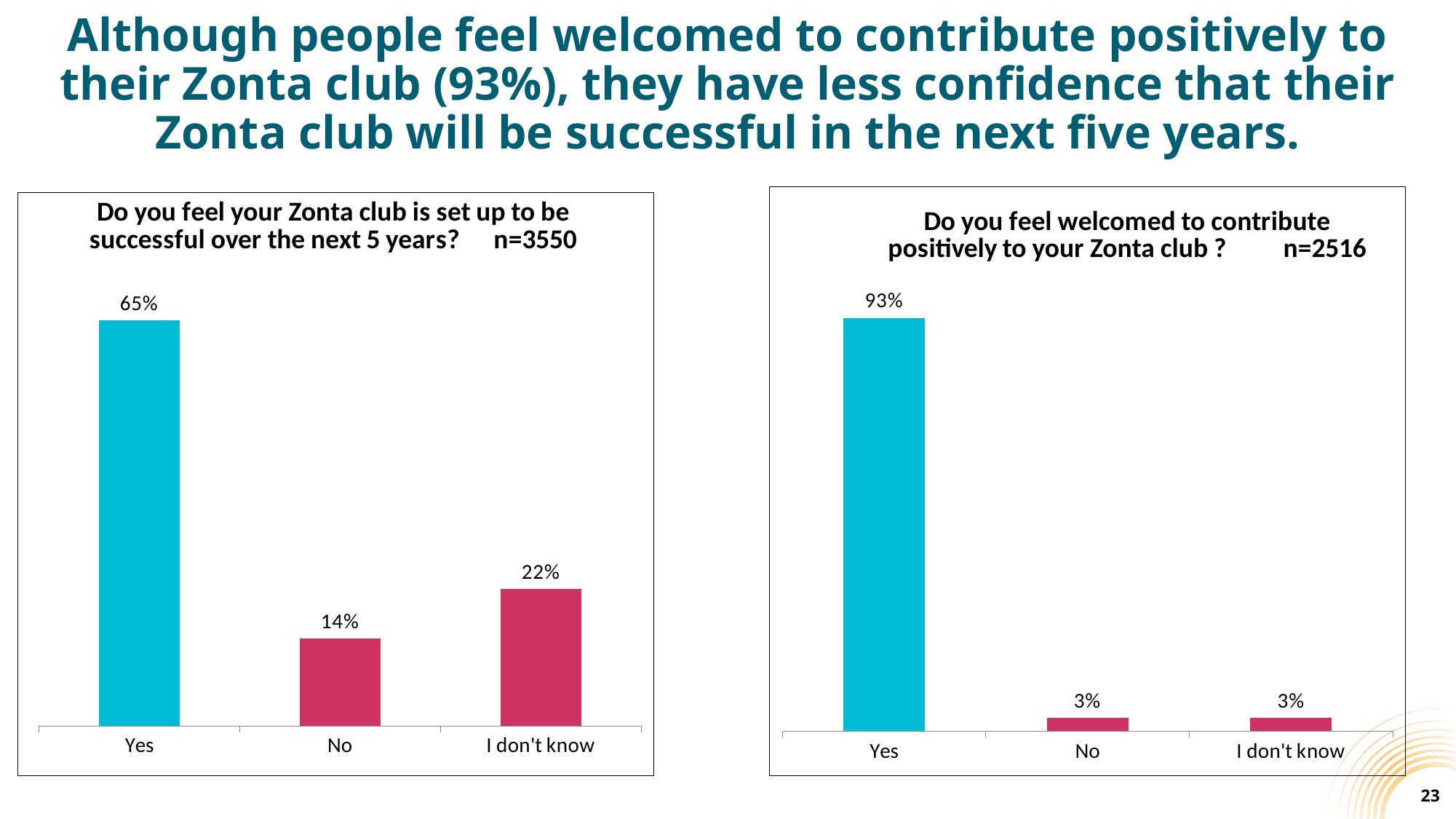
In the left chart (Do you feel your Zonta club is set up to be successful over the next 5 years?), which category has the lowest value? No In the right chart (Do you feel welcomed to contribute positively to your Zonta club?), what is the value for No? 3% In the left chart (Do you feel your Zonta club is set up to be successful over the next 5 years?), what is the value for I don't know? 22% How many categories are shown in the right chart (Do you feel welcomed to contribute positively to your Zonta club?)? 3 In the right chart (Do you feel welcomed to contribute positively to your Zonta club?), what is the difference between the Yes and No values? 90% What type of chart is the left chart (Do you feel your Zonta club is set up to be successful over the next 5 years?)? Bar chart In the right chart (Do you feel welcomed to contribute positively to your Zonta club?), what is the value for Yes? 93% In the right chart (Do you feel welcomed to contribute positively to your Zonta club?), which category has the highest value? Yes In the left chart (Do you feel your Zonta club is set up to be successful over the next 5 years?), what is the value for No? 14% In the left chart (Do you feel your Zonta club is set up to be successful over the next 5 years?), which is larger, the value for No or the value for I don't know? I don't know In the left chart (Do you feel your Zonta club is set up to be successful over the next 5 years?), what is the value for Yes? 65% In the left chart (Do you feel your Zonta club is set up to be successful over the next 5 years?), what is the difference between the Yes and I don't know values? 43%